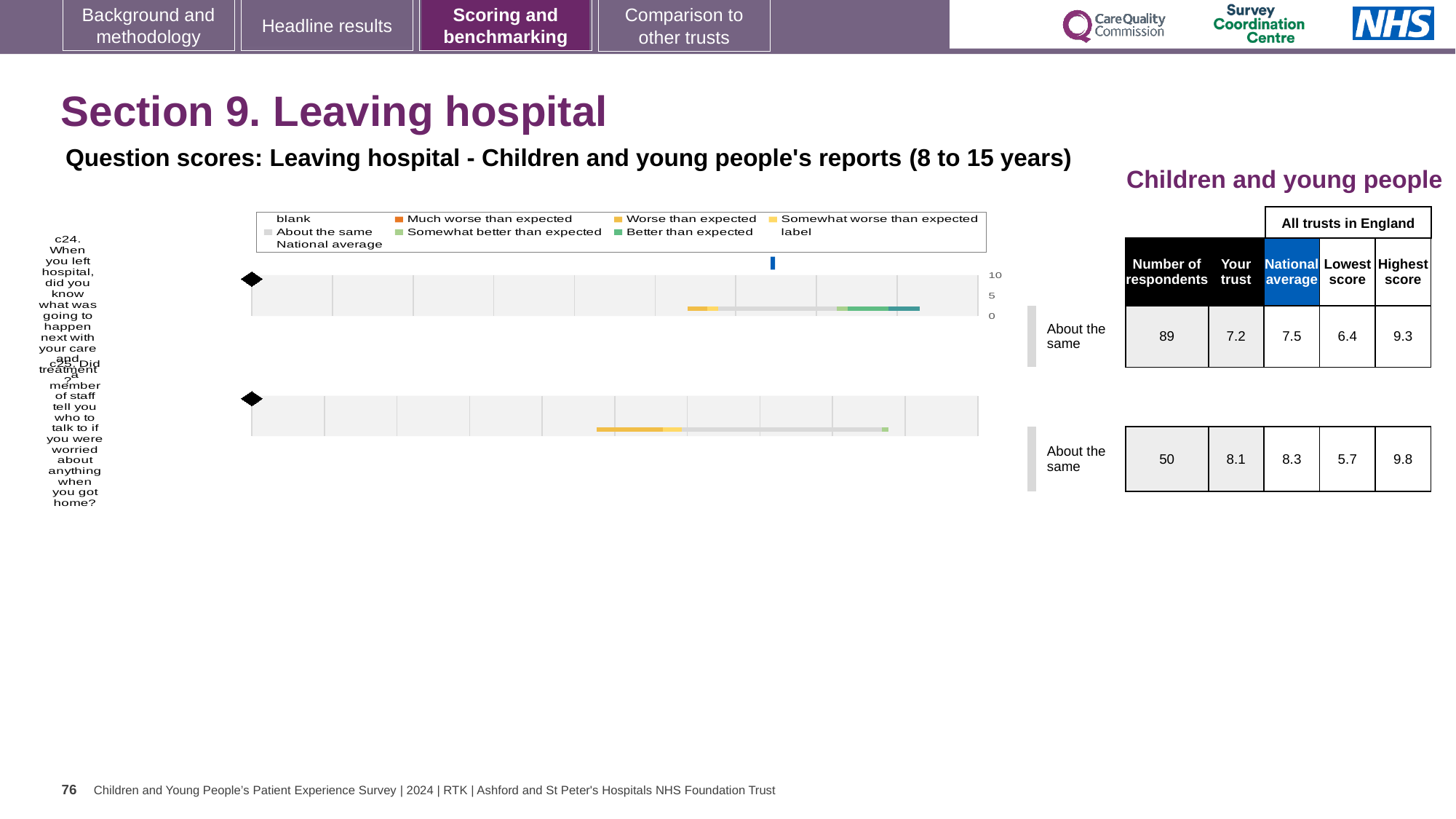
What is the difference between the highest and lowest scores in England for question c25? 4.1 How many questions (bars) are plotted in the Leaving hospital chart? 2 What is the national average score for question c25 (Did a member of staff tell you who to talk to if you were worried about anything when you got home?)? 8.3 What is the difference between the national average and the trust's score for question c24? 0.3 What is the highest score across all trusts in England for question c25? 9.8 Which question had more respondents, c24 or c25? c24 What is the lowest score across all trusts in England for question c24? 6.4 Which question has the higher 'Your trust' score, c24 or c25? c25 How many respondents answered question c24? 89 What kind of chart is used to show the question scores for Leaving hospital? bar chart What is the 'Your trust' score for question c24 (When you left hospital, did you know what was going to happen next with your care and treatment?)? 7.2 What benchmark category is shown for both c24 and c25 in the Leaving hospital chart? About the same